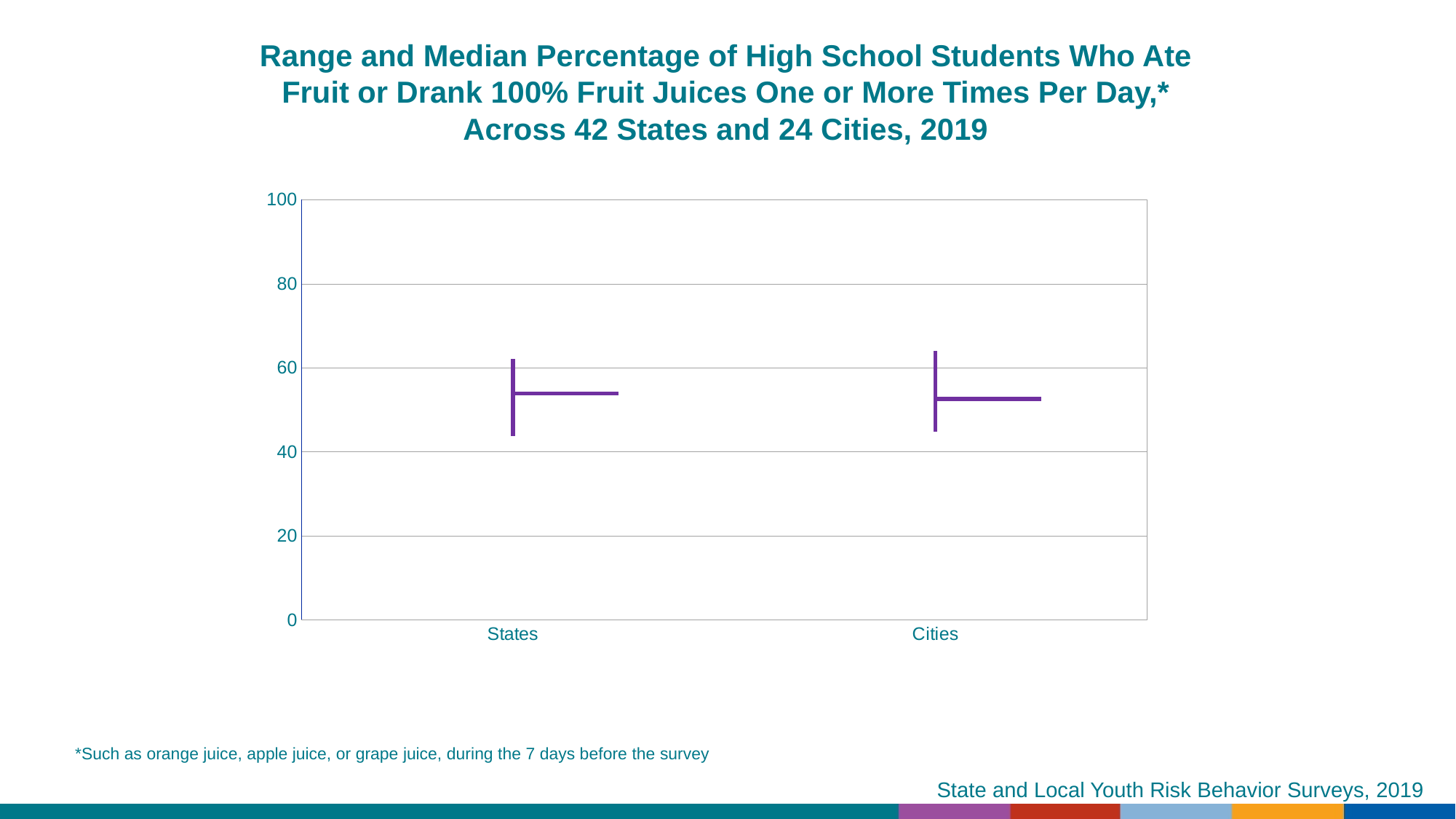
Is the bottom of the range for Cities greater or less than 60? less What is the highest value shown on the y axis? 100 Is the top of the range for Cities greater or less than 80? less Is the median value for Cities greater or less than 60? less How many categories are shown on the x axis of the chart? 2 What are the two categories shown on the x axis? States and Cities